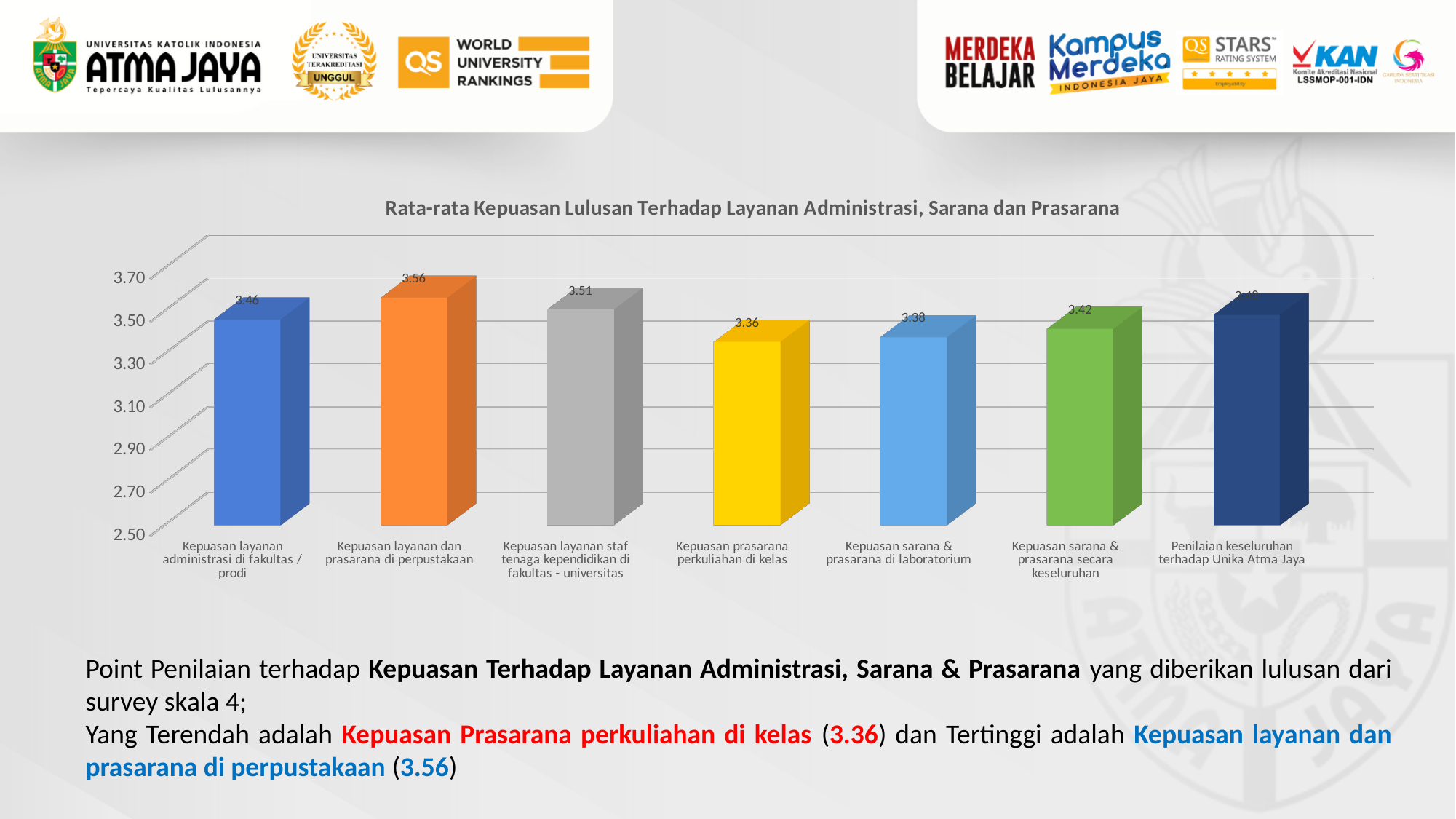
What is the value for Kepuasan sarana & prasarana secara keseluruhan? 3.42 Which category has the lowest value? Kepuasan prasarana perkuliahan di kelas What is the value for Kepuasan layanan administrasi di fakultas / prodi? 3.46 What is the value for Kepuasan prasarana perkuliahan di kelas? 3.36 Which is larger: the value for Kepuasan layanan dan prasarana di perpustakaan or the value for Kepuasan sarana & prasarana di laboratorium? Kepuasan layanan dan prasarana di perpustakaan How many categories are shown in the chart? 7 What is the value for Kepuasan sarana & prasarana di laboratorium? 3.38 What is the difference between the value for Kepuasan layanan dan prasarana di perpustakaan and the value for Kepuasan prasarana perkuliahan di kelas? 0.20 What is the value for Kepuasan layanan staf tenaga kependidikan di fakultas - universitas? 3.51 What is the value for Kepuasan layanan dan prasarana di perpustakaan? 3.56 What kind of chart is shown on the slide? Bar chart Which category has the highest value? Kepuasan layanan dan prasarana di perpustakaan